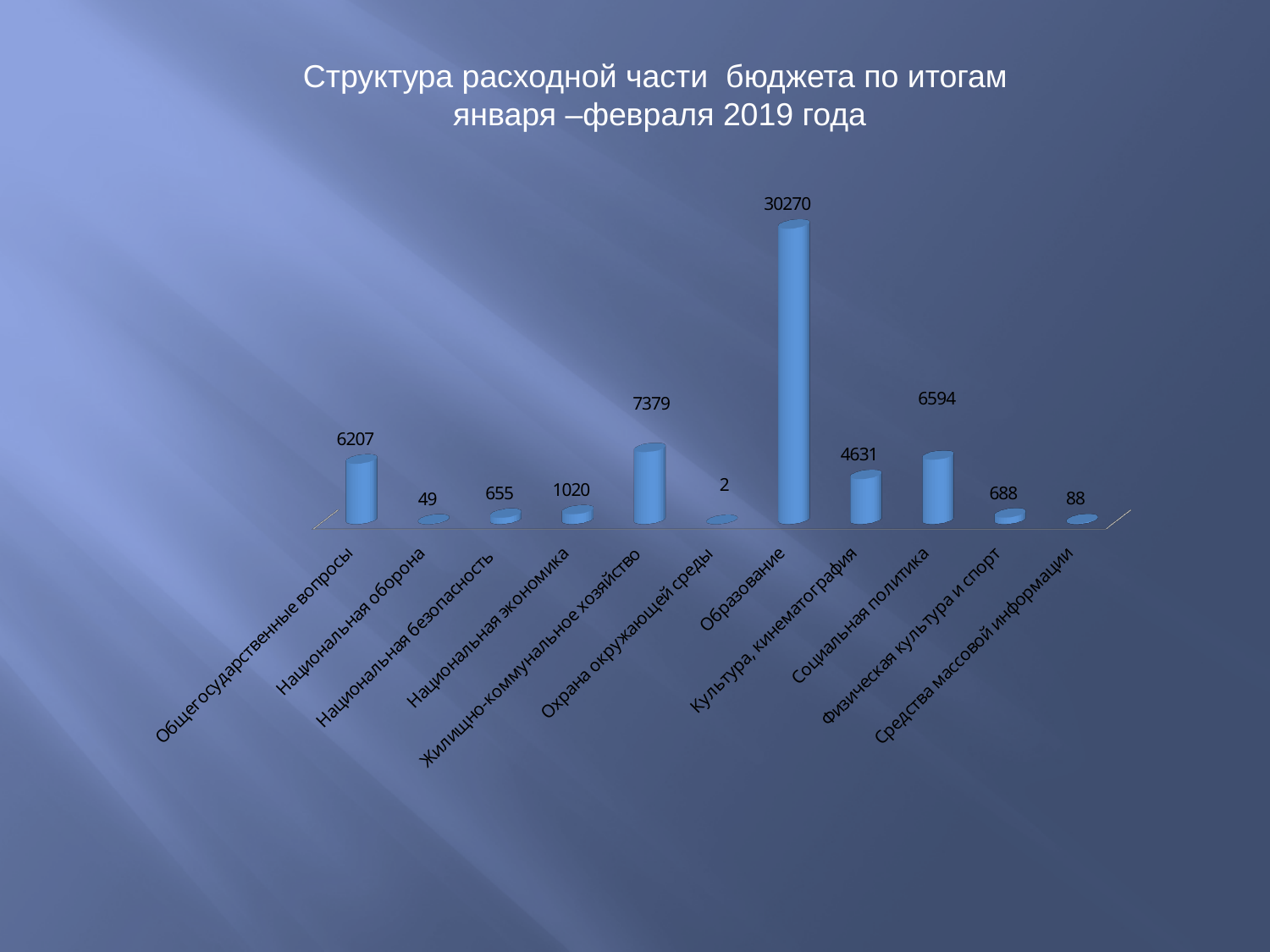
What is the difference between the values for Образование and Жилищно-коммунальное хозяйство? 22891 What is the difference between the values for Социальная политика and Культура, кинематография? 1963 What is the value for Социальная политика? 6594 Which category has the lowest value? Охрана окружающей среды Which is larger, the value for Общегосударственные вопросы or the value for Социальная политика? Социальная политика What is the value for Национальная оборона? 49 What is the value for Образование? 30270 Which category has the highest value? Образование What is the value for Жилищно-коммунальное хозяйство? 7379 What is the title of the chart? Структура расходной части бюджета по итогам января –февраля 2019 года What kind of chart is shown on the slide? Bar chart How many categories are shown in the chart? 11